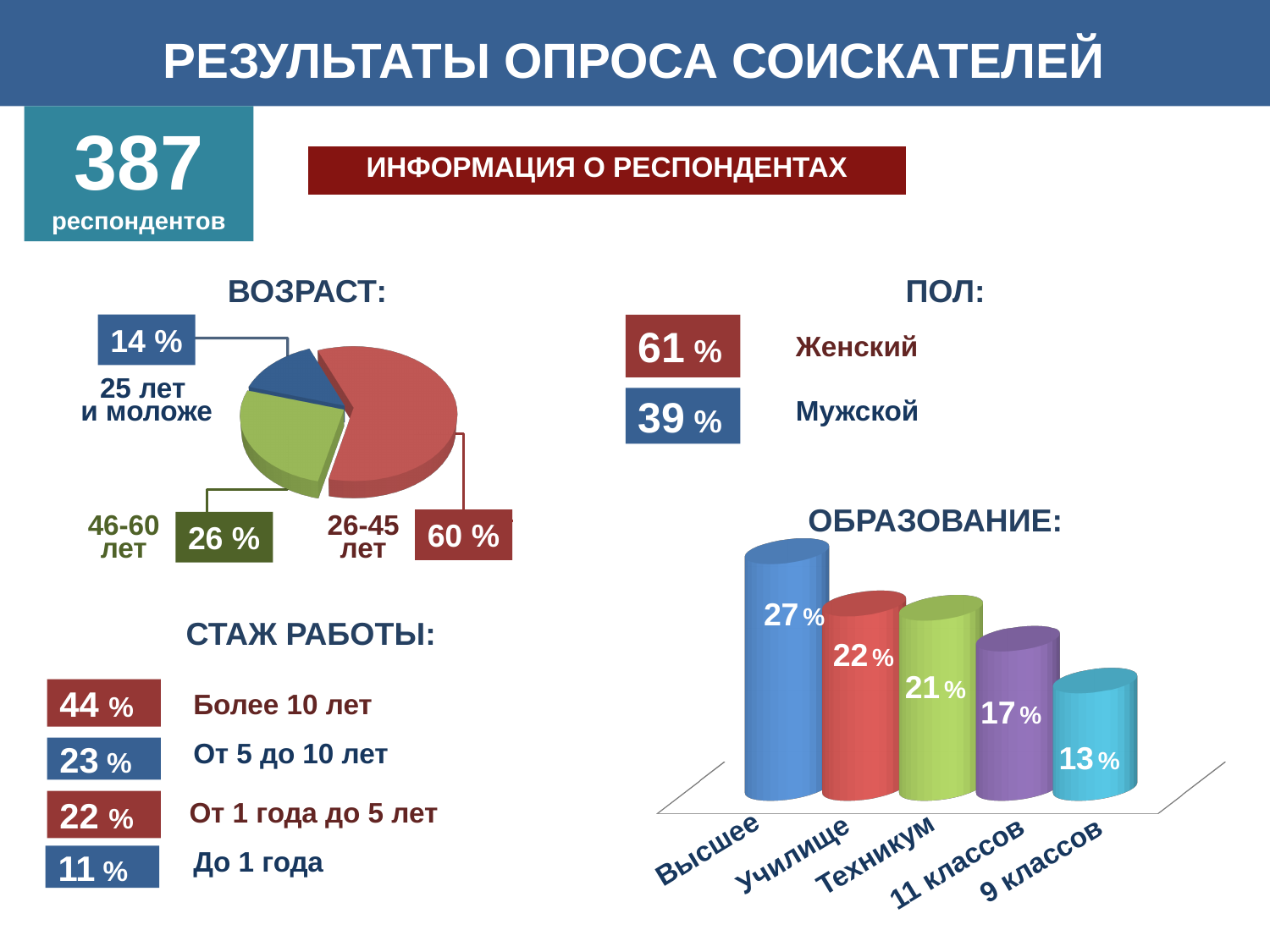
In the ОБРАЗОВАНИЕ chart, do the values rise or fall from Высшее to 9 классов? Fall In the ОБРАЗОВАНИЕ chart, which category has the highest value? Высшее In the ВОЗРАСТ chart, which age group has the smallest share? 25 лет и моложе In the ОБРАЗОВАНИЕ chart, what is the value for 9 классов? 13 % In the ВОЗРАСТ chart, which age group has the largest share? 26-45 лет In the ОБРАЗОВАНИЕ chart, what is the difference between Высшее and 11 классов? 10 % In the ВОЗРАСТ chart, what share of respondents are 25 лет и моложе? 14 % In the ВОЗРАСТ chart, what share of respondents are 26-45 лет? 60 % In the ОБРАЗОВАНИЕ chart, what is the value for Техникум? 21 % What kind of chart is the ВОЗРАСТ chart? Pie chart In the ОБРАЗОВАНИЕ chart, how many categories are shown? 5 In the ВОЗРАСТ chart, what is the difference between the shares for 26-45 лет and 46-60 лет? 34 %